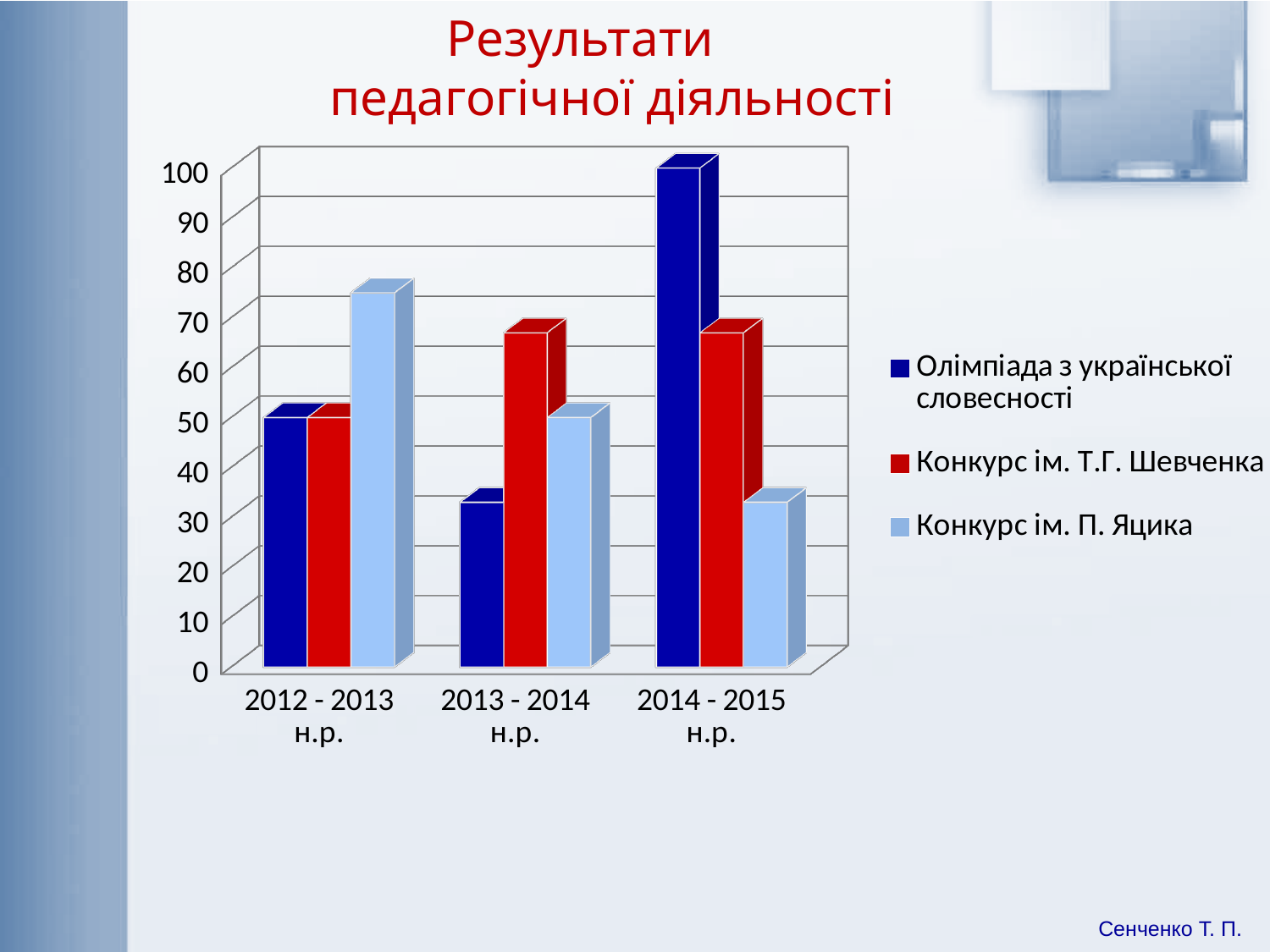
How many academic-year categories are shown on the x axis? 3 In which academic year is the value for Олімпіада з української словесності highest? 2014 - 2015 н.р. In which academic year is the value for Конкурс ім. П. Яцика lowest? 2014 - 2015 н.р. What kind of chart is shown on the slide? bar chart In 2013 - 2014 н.р., which is larger: Конкурс ім. Т.Г. Шевченка or Олімпіада з української словесності? Конкурс ім. Т.Г. Шевченка Is the value for Олімпіада з української словесності in 2014 - 2015 н.р. greater or less than 90? greater Is the value for Конкурс ім. П. Яцика in 2012 - 2013 н.р. greater or less than 70? greater Do the values for Конкурс ім. П. Яцика rise or fall from 2012 - 2013 н.р. to 2014 - 2015 н.р.? fall Is the value for Конкурс ім. П. Яцика in 2014 - 2015 н.р. greater or less than 40? less How many series does the legend list? 3